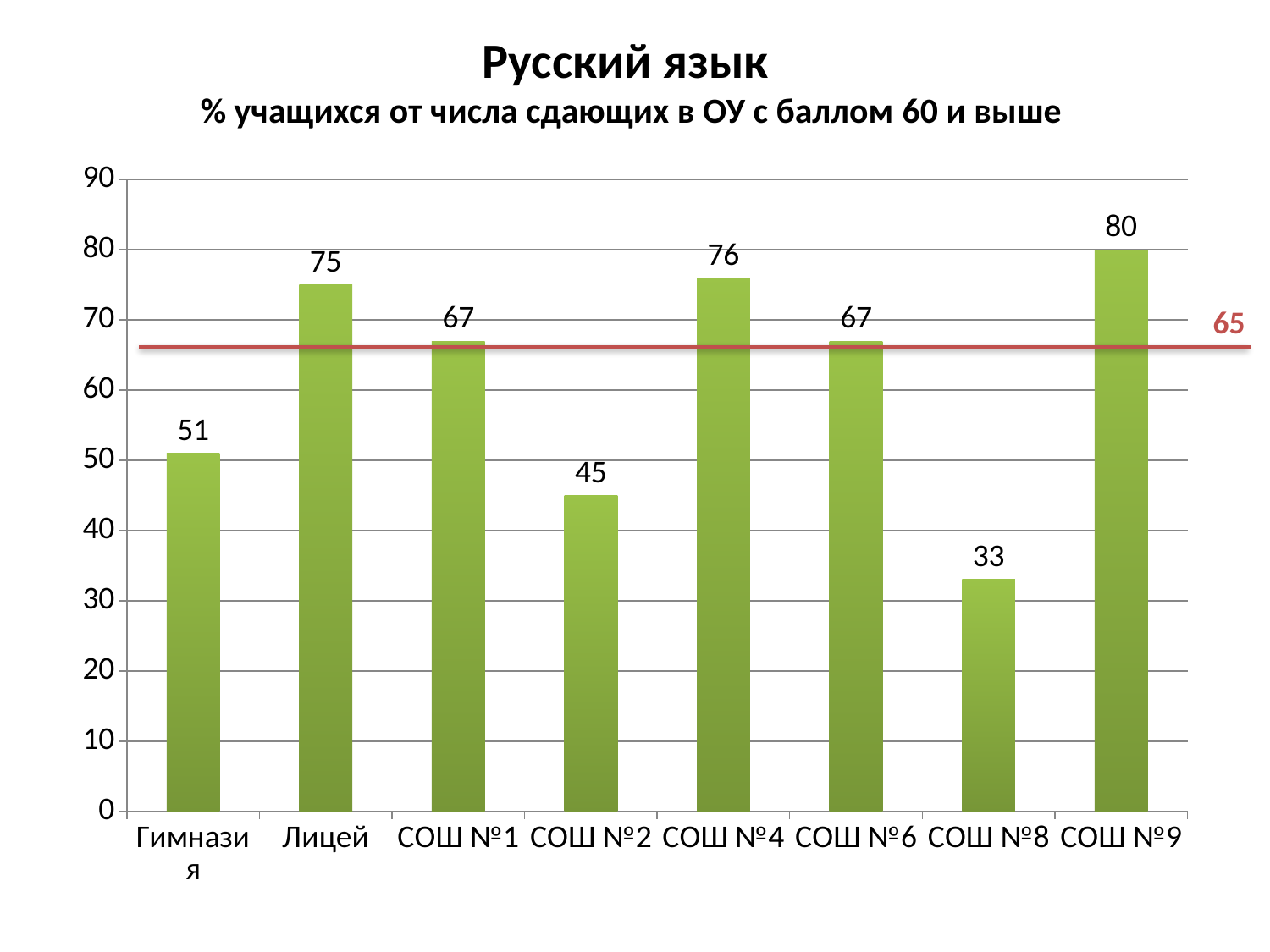
Which category has the highest value? СОШ №9 What value does the red horizontal line mark? 65 How many categories are shown on the x axis? 8 What kind of chart is this? bar chart What is the title of the chart? Русский язык Which is larger, the value for СОШ №4 or the value for Лицей? СОШ №4 What is the value for Гимназия? 51 Is the value for СОШ №2 greater or less than 50? less Which category has the lowest value? СОШ №8 What is the value for СОШ №8? 33 What is the value for Лицей? 75 What is the difference between the values for СОШ №9 and СОШ №2? 35